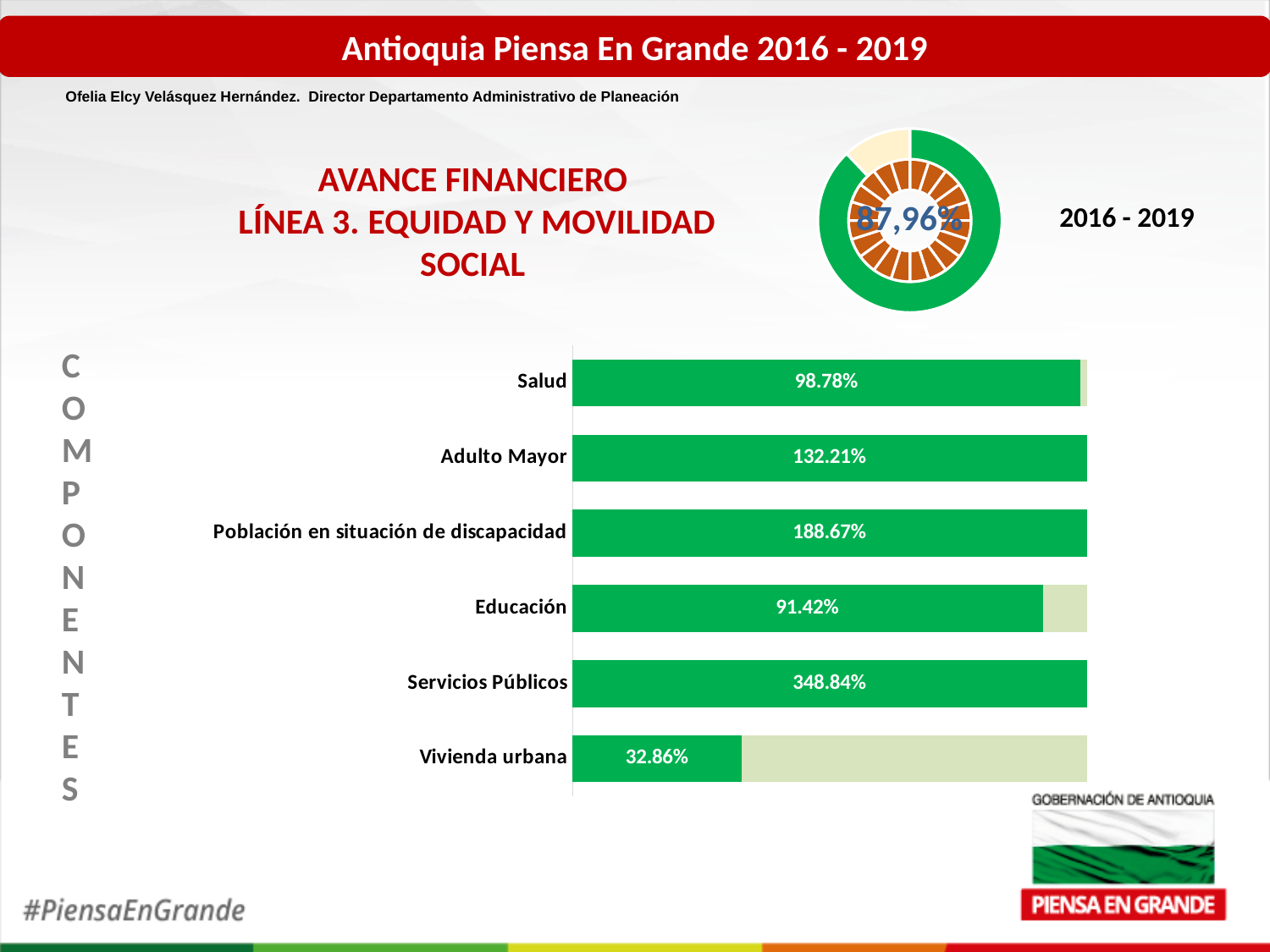
In the bar chart, which category has the highest value? Servicios Públicos In the bar chart, what is the value for Adulto Mayor? 132.21% In the bar chart, what is the value for Salud? 98.78% How many categories does the bar chart show? 6 In the bar chart, which is larger, the value for Adulto Mayor or the value for Educación? Adulto Mayor In the bar chart, what is the value for Población en situación de discapacidad? 188.67% What kind of chart is the chart listing Salud, Adulto Mayor and Educación? bar chart In the bar chart, what is the difference between the values for Salud and Educación? 7.36% In the bar chart, which category has the lowest value? Vivienda urbana What percentage is shown in the centre of the donut chart at the top of the slide? 87,96% What kind of chart is the chart at the top of the slide showing 87,96%? donut chart In the bar chart, what is the value for Vivienda urbana? 32.86%